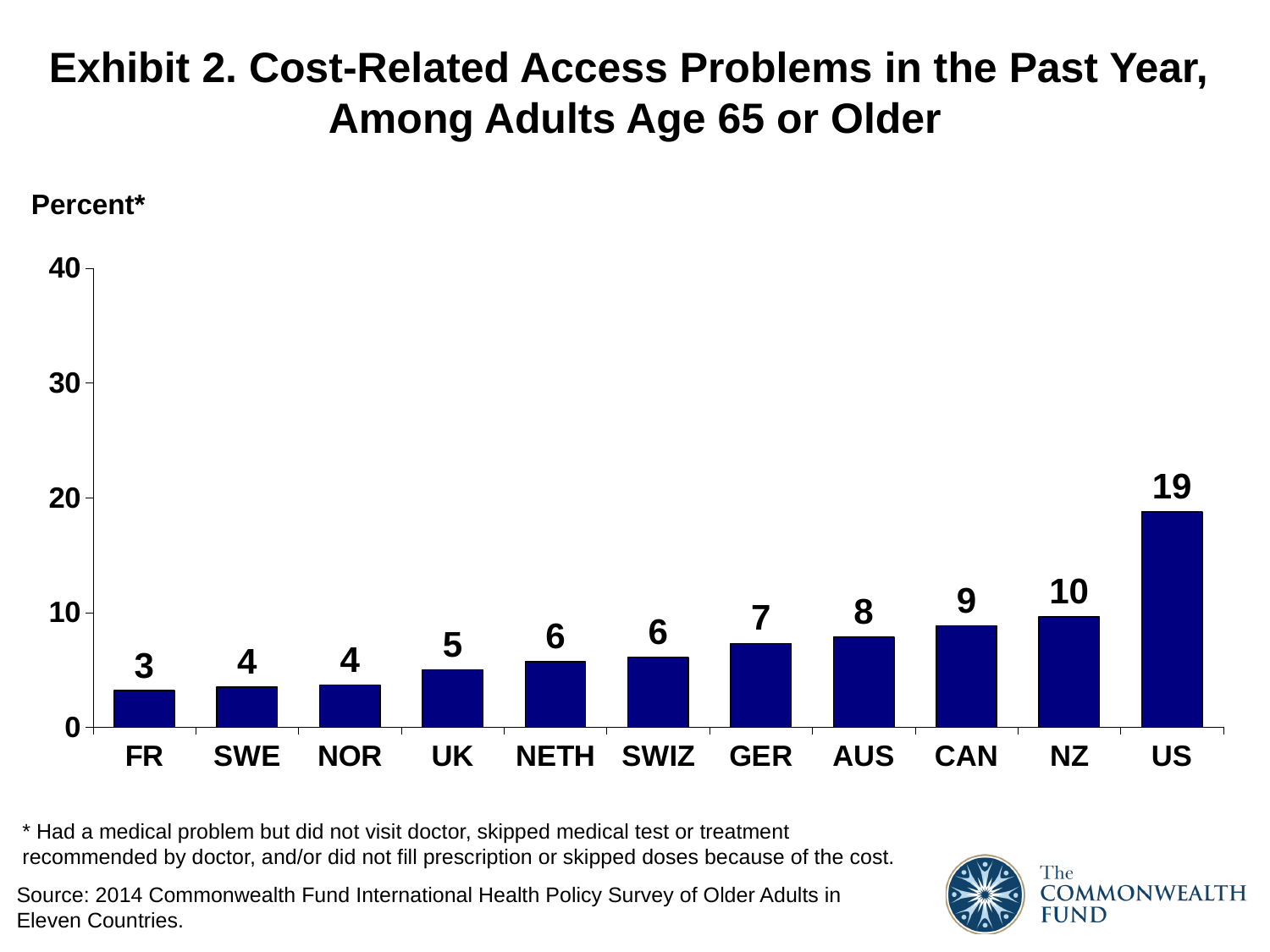
How many countries are shown on the chart? 11 What is the value for CAN? 9 What is the value for the US? 19 Which is larger, the value for AUS or the value for UK? AUS What is the difference between the values for GER and FR? 4 Is the value for the US greater or less than 10? greater Which country has the lowest value? FR What is the value for NETH? 6 Do the values rise or fall from left to right across the countries? rise Which country has the highest value? US What is the difference between the values for the US and NZ? 9 What kind of chart is shown on the slide? bar chart